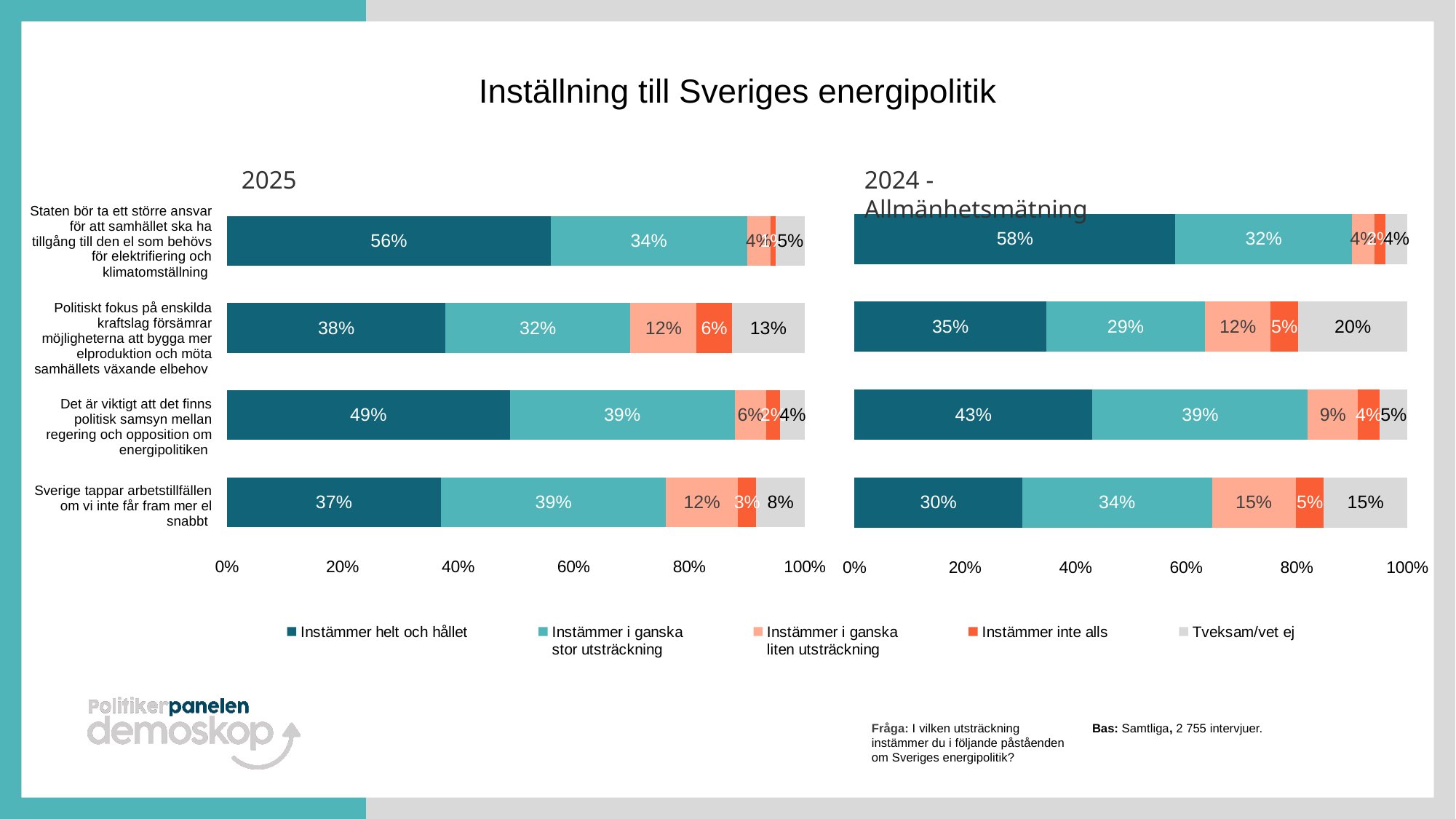
In the 2025 chart, what is the value for "Instämmer helt och hållet" for the statement "Staten bör ta ett större ansvar för att samhället ska ha tillgång till den el som behövs för elektrifiering och klimatomställning"? 56% How many statements are shown in the 2025 chart? 4 What is the title of the slide's chart? Inställning till Sveriges energipolitik In the 2024 - Allmänhetsmätning chart, what is the value for "Instämmer i ganska liten utsträckning" for the statement "Sverige tappar arbetstillfällen om vi inte får fram mer el snabbt"? 15% In the 2024 - Allmänhetsmätning chart, what is the value for "Tveksam/vet ej" for the statement "Politiskt fokus på enskilda kraftslag försämrar möjligheterna att bygga mer elproduktion och möta samhällets växande elbehov"? 20% In the 2025 chart, what is the difference between "Instämmer helt och hållet" and "Instämmer i ganska stor utsträckning" for the statement "Politiskt fokus på enskilda kraftslag försämrar möjligheterna att bygga mer elproduktion och möta samhällets växande elbehov"? 6 percentage points In the 2025 chart, which statement has the highest share of "Instämmer helt och hållet"? Staten bör ta ett större ansvar för att samhället ska ha tillgång till den el som behövs för elektrifiering och klimatomställning How many series does the legend list? 5 In the 2024 - Allmänhetsmätning chart, which statement has the larger "Tveksam/vet ej" share: "Sverige tappar arbetstillfällen om vi inte får fram mer el snabbt" or "Politiskt fokus på enskilda kraftslag försämrar möjligheterna att bygga mer elproduktion och möta samhällets växande elbehov"? Politiskt fokus på enskilda kraftslag försämrar möjligheterna att bygga mer elproduktion och möta samhällets växande elbehov What kind of chart is the 2025 chart? Stacked bar chart In the 2024 - Allmänhetsmätning chart, which statement has the lowest share of "Instämmer helt och hållet"? Sverige tappar arbetstillfällen om vi inte får fram mer el snabbt In the 2025 chart, what is the value for "Instämmer inte alls" for the statement "Politiskt fokus på enskilda kraftslag försämrar möjligheterna att bygga mer elproduktion och möta samhällets växande elbehov"? 6%